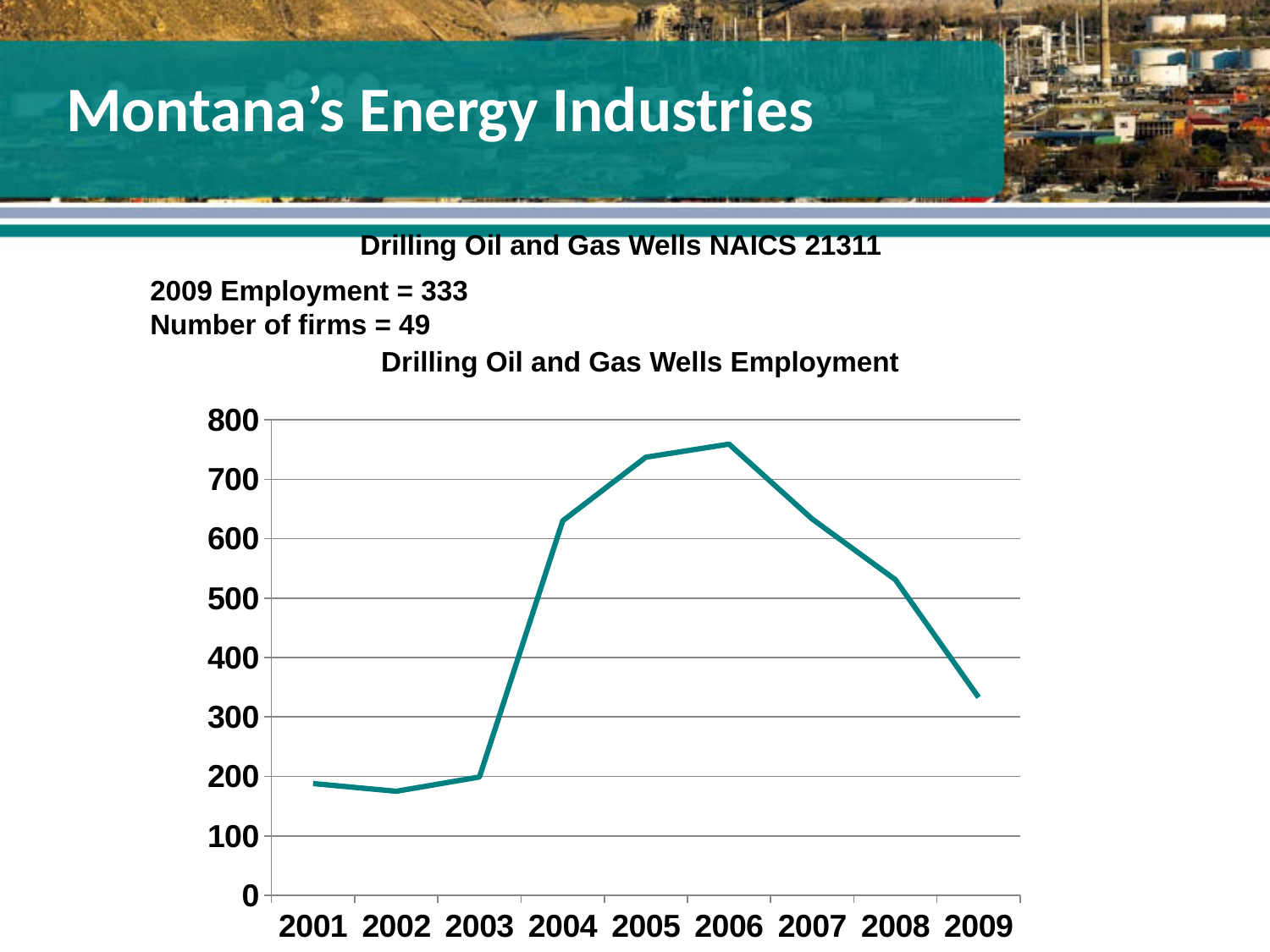
Is the value for 2005 greater or less than 700? greater Is the value for 2008 greater or less than 500? greater What is the employment value for 2009 in the chart? 333 How many years are plotted on the x axis of the chart? 9 Which year has the larger employment value, 2003 or 2004? 2004 Is the value for 2003 greater or less than 300? less Do the employment values rise or fall from 2006 to 2009? fall Which year has the highest employment in the chart? 2006 What is the title of the chart? Drilling Oil and Gas Wells Employment What kind of chart is shown on the slide? line chart Which year has the larger employment value, 2006 or 2009? 2006